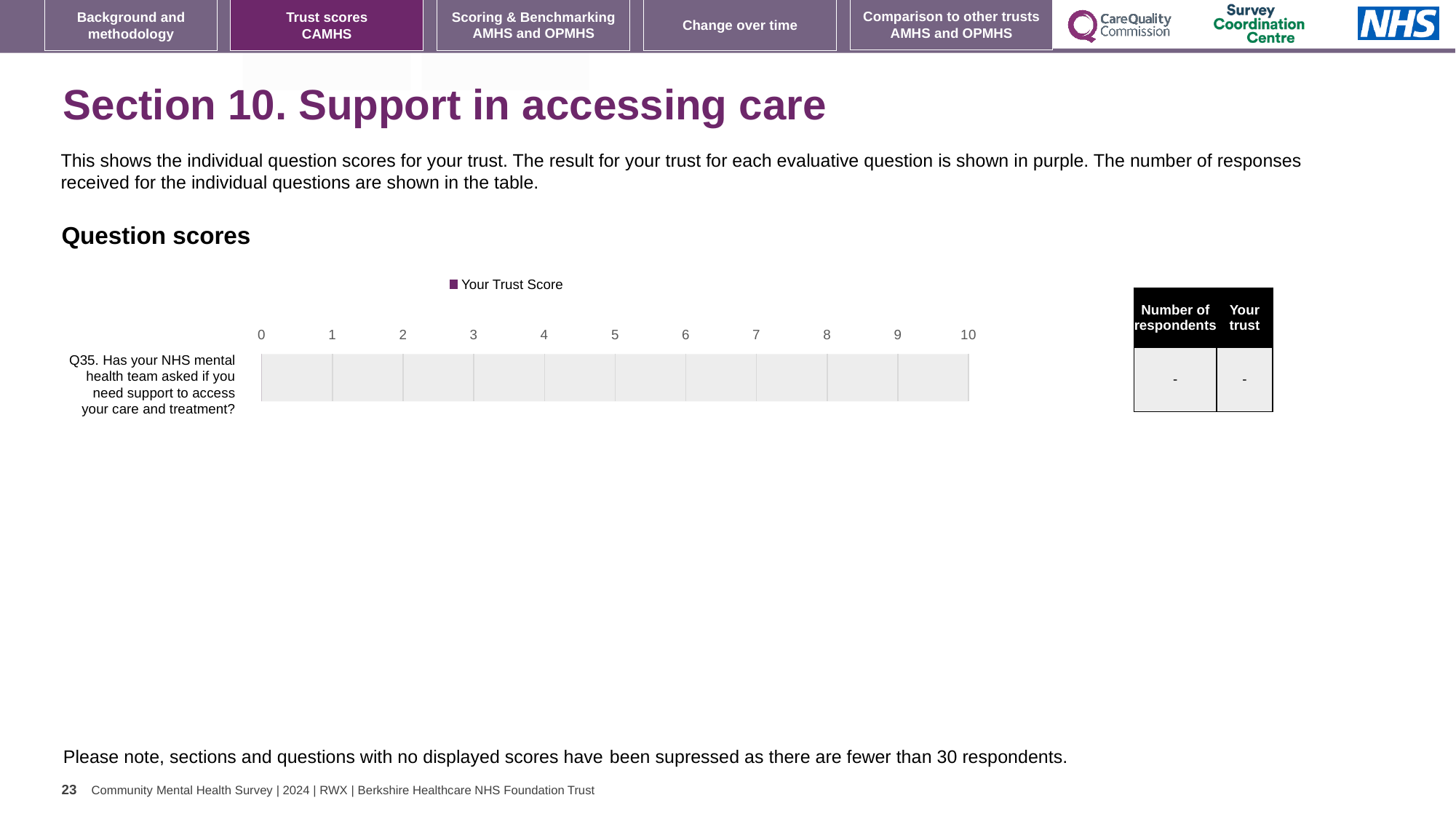
What value is shown in the 'Your trust' column of the table for Q35? - What is the lowest value shown on the chart's horizontal axis? 0 How many questions (categories) are listed on the chart's vertical axis? 1 How many series does the chart legend list? 1 Which question is listed on the chart's vertical axis? Q35. Has your NHS mental health team asked if you need support to access your care and treatment? What value is shown in the 'Number of respondents' column of the table for Q35? - What is the highest value shown on the chart's horizontal axis? 10 What kind of chart is shown under the 'Question scores' heading? bar chart